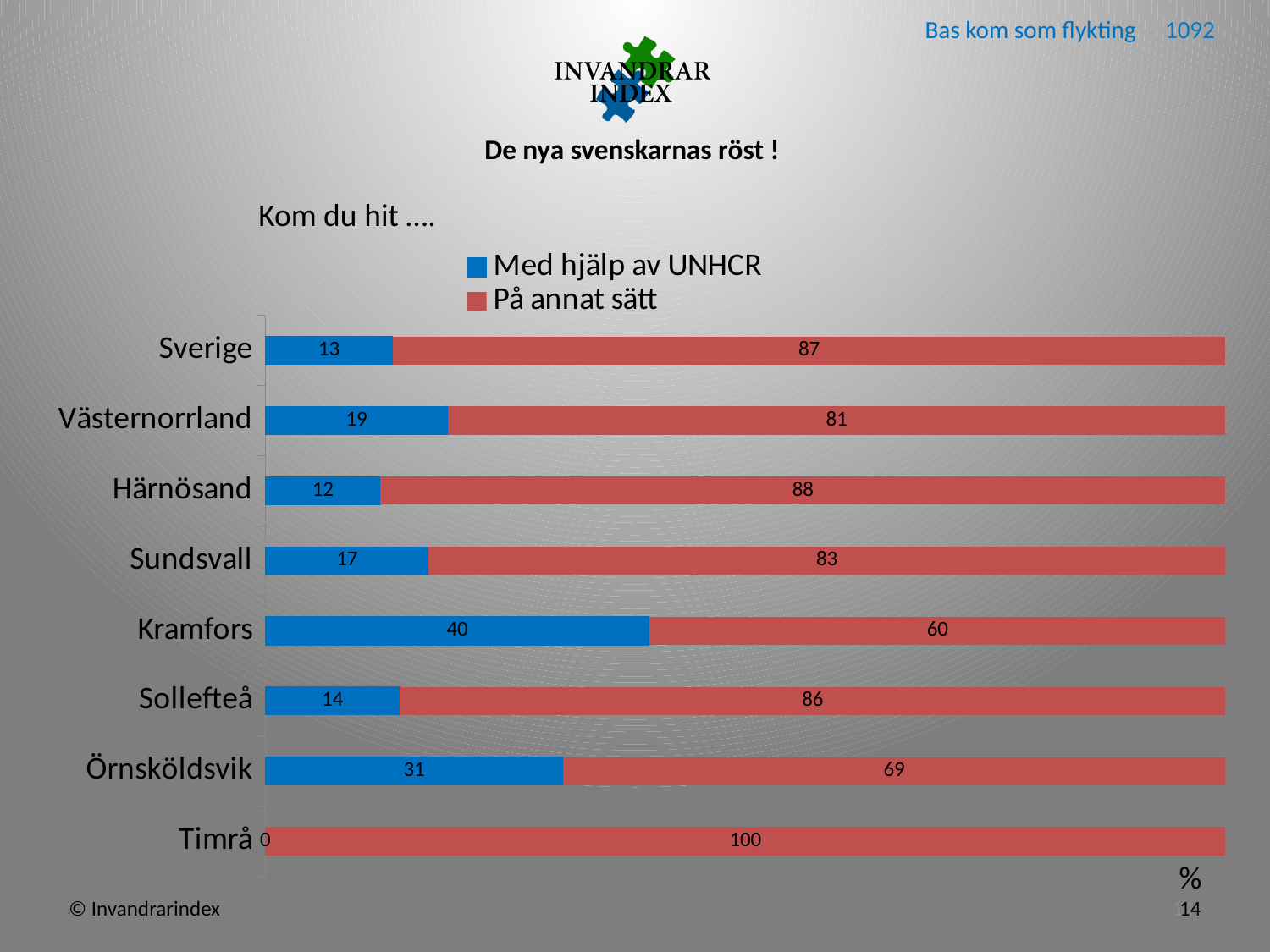
Which is larger: the 'Med hjälp av UNHCR' value for Västernorrland or for Sundsvall? Västernorrland What is the difference between the 'På annat sätt' and 'Med hjälp av UNHCR' values for Örnsköldsvik? 38 What kind of chart is shown on the slide? Stacked bar chart What is the value for 'Med hjälp av UNHCR' for Kramfors? 40 What is the total of the stacked bar for Sollefteå? 100 How many series does the legend list? 2 Which series is shown in blue in the legend? Med hjälp av UNHCR Which category has the lowest value for 'På annat sätt'? Kramfors Which category has the highest value for 'Med hjälp av UNHCR'? Kramfors What is the value for 'Med hjälp av UNHCR' for Timrå? 0 How many categories are shown on the chart? 8 What is the value for 'På annat sätt' for Härnösand? 88